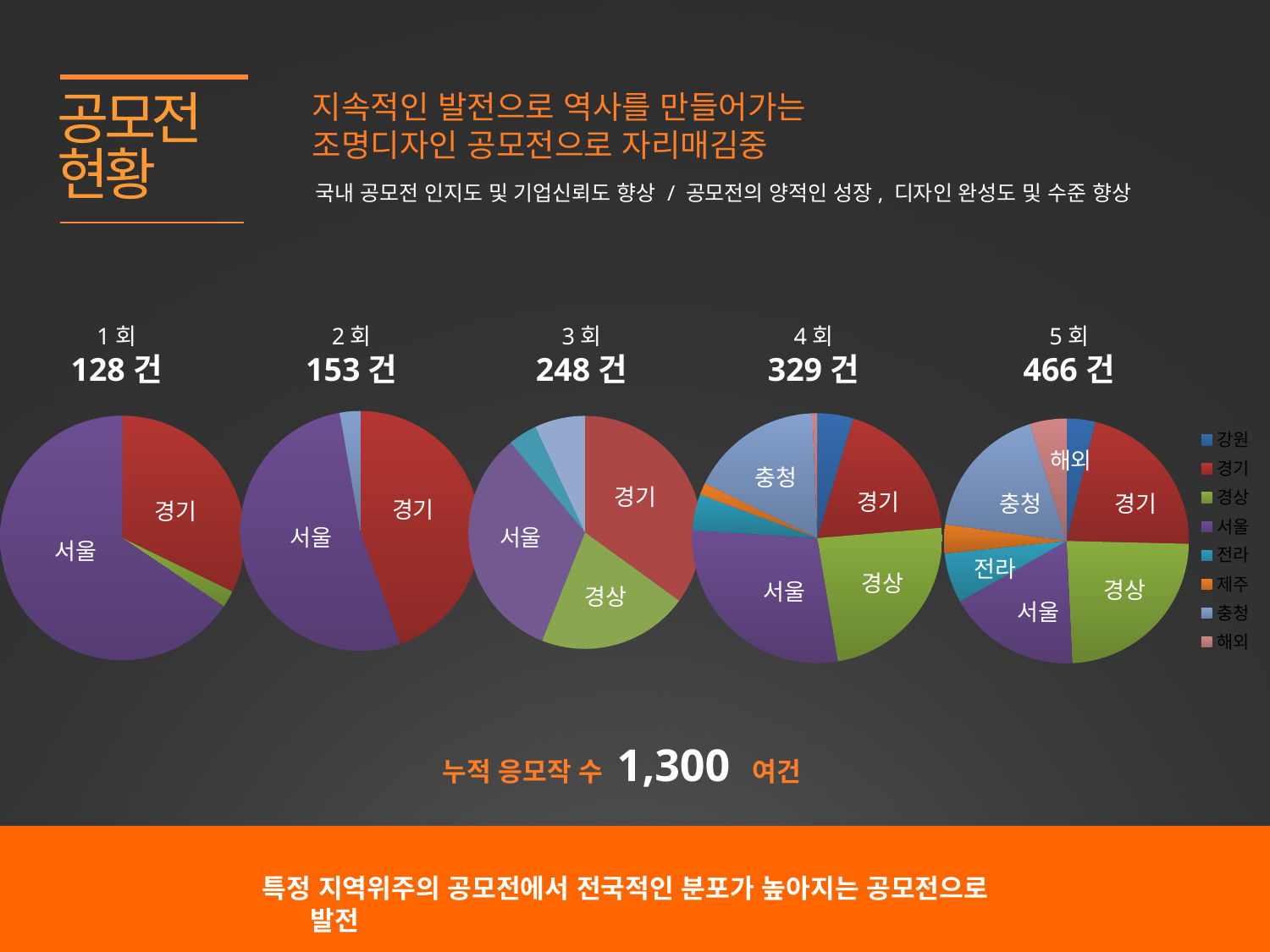
In the 1회 pie chart, which region has the largest slice? 서울 How many pie charts are shown on the slide? 5 Do the totals rise or fall from 1회 to 5회? Rise What kind of charts are shown on the slide? Pie charts How many entries does the legend list? 8 Which round (회) has the highest total number of entries? 5 회 What is the total number of entries shown for the 5회 pie chart? 466 건 Which has a larger total, the 2회 pie chart or the 3회 pie chart? 3 회 Which round (회) has the lowest total number of entries? 1 회 What is the total number of entries shown for the 1회 pie chart? 128 건 What is the total number of entries shown for the 3회 pie chart? 248 건 What is the difference between the totals of the 5회 and 4회 pie charts? 137 건